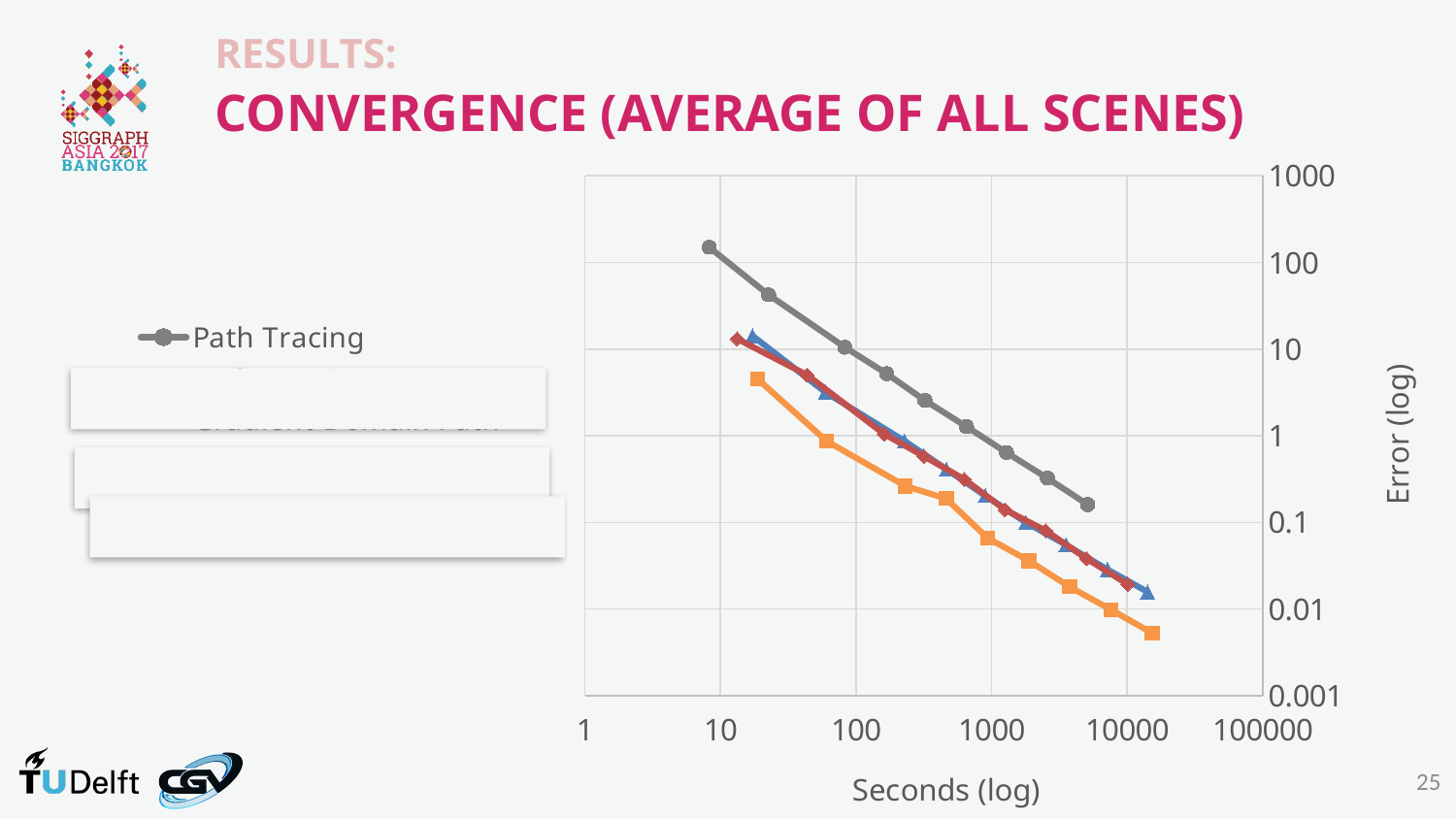
What is the title of the chart on the slide? CONVERGENCE (AVERAGE OF ALL SCENES) Which series has the highest error across the plotted time range? Path Tracing What is the label of the x axis? Seconds (log) What is the label of the y axis? Error (log) How many data points are plotted for Path Tracing? 9 Is the error of the first Path Tracing point greater or less than 10? greater Does the error for Path Tracing rise or fall as seconds increase? fall What kind of chart is shown on the slide? line chart Is the error of the last Path Tracing point greater or less than 1? less